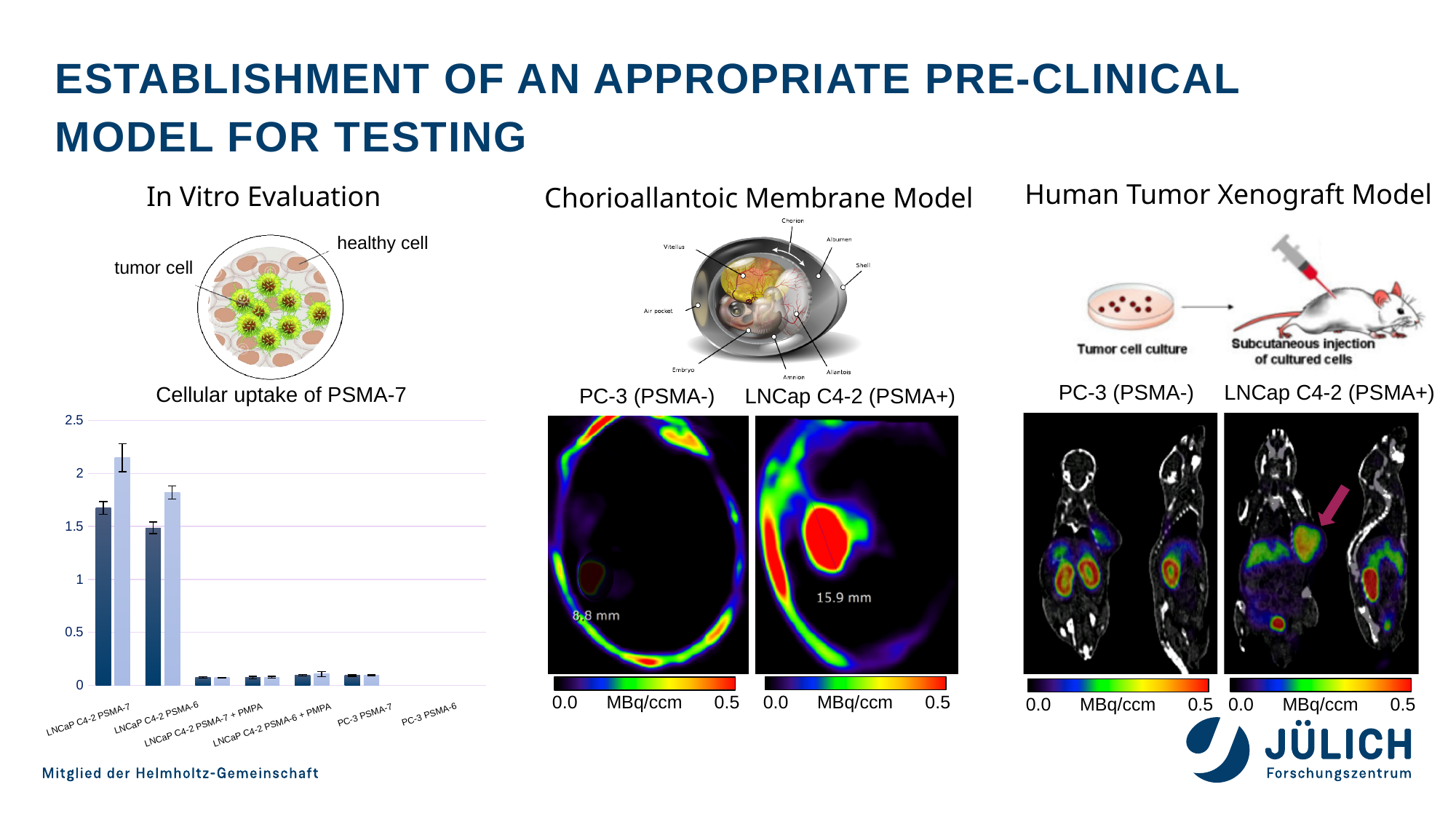
In the "Cellular uptake of PSMA-7" chart, which is larger: the dark blue bar for LNCaP C4-2 PSMA-7 or the dark blue bar for PC-3 PSMA-7? LNCaP C4-2 PSMA-7 In the "Cellular uptake of PSMA-7" chart, for LNCaP C4-2 PSMA-6, which bar is taller: the dark blue or the light blue? light blue What is the title of the bar chart on the slide? Cellular uptake of PSMA-7 In the "Cellular uptake of PSMA-7" chart, is the dark blue bar for LNCaP C4-2 PSMA-7 greater or less than 1.5? greater What kind of chart is "Cellular uptake of PSMA-7"? bar chart What is the highest value shown on the y axis of the "Cellular uptake of PSMA-7" chart? 2.5 In the "Cellular uptake of PSMA-7" chart, which category has the tallest bar? LNCaP C4-2 PSMA-7 In the "Cellular uptake of PSMA-7" chart, is the light blue bar for LNCaP C4-2 PSMA-6 greater or less than 2? less In the "Cellular uptake of PSMA-7" chart, are the bars for LNCaP C4-2 PSMA-7 + PMPA greater or less than 0.5? less How many categories are shown on the x axis of the "Cellular uptake of PSMA-7" chart? 6